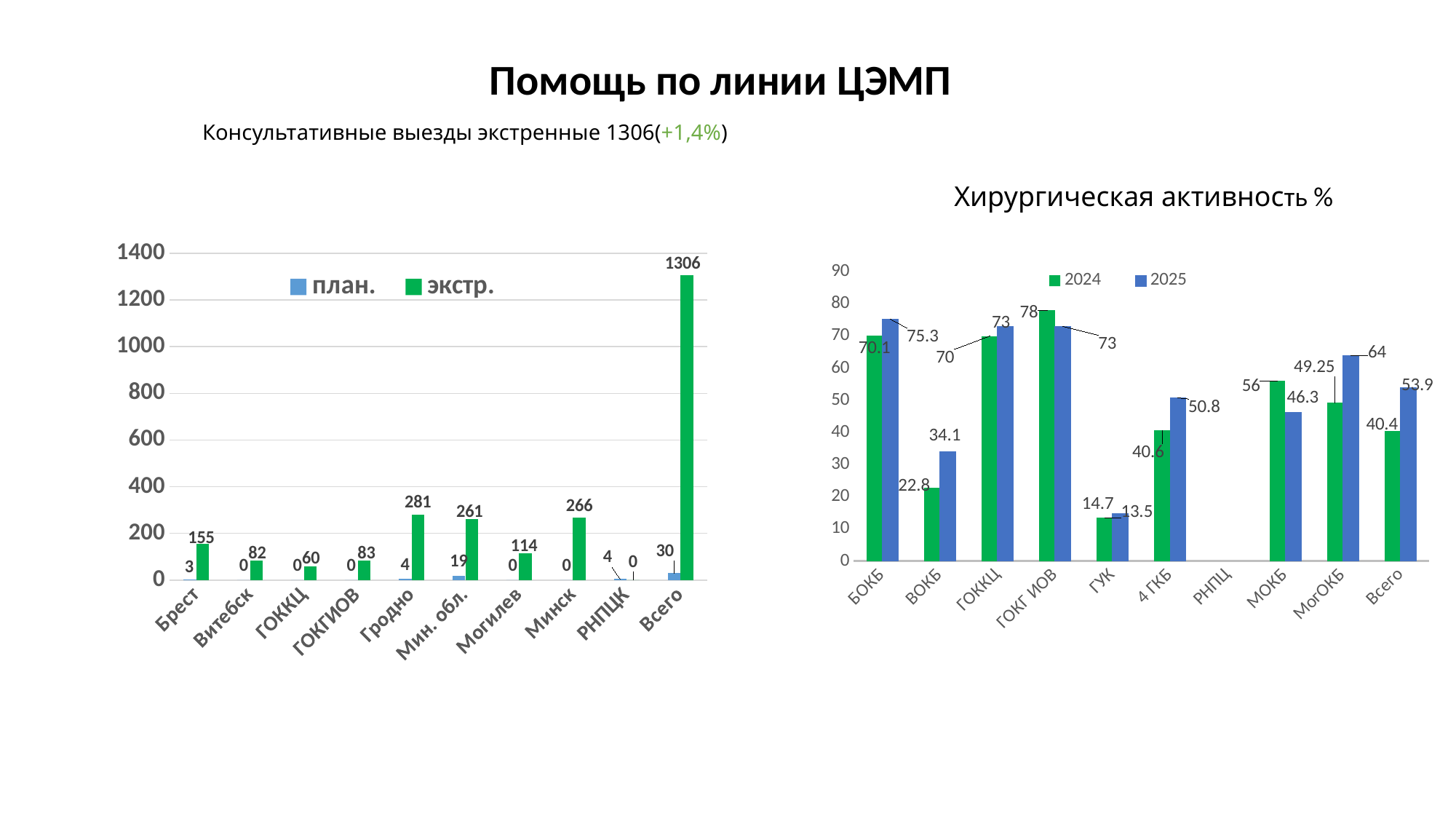
In the left chart, what is the difference between the экстр. values for Минск and Мин. обл.? 5 What kind of chart is the chart titled 'Хирургическая активность %'? Bar chart In the left chart, excluding Всего, which category has the highest экстр. value? Гродно In the chart titled 'Хирургическая активность %', what is the 2024 value for ВОКБ? 22.8 In the chart titled 'Хирургическая активность %', what is the difference between the 2025 and 2024 values for 4 ГКБ? 10.2 In the left chart, what is the план. value for Мин. обл.? 19 In the left chart, which is larger: the экстр. value for Могилев or for Витебск? Могилев In the chart titled 'Хирургическая активность %', which category has the lowest 2025 value? ГУК In the left chart, how many series does the legend list? 2 In the chart titled 'Хирургическая активность %', which is larger for МОКБ: the 2024 value or the 2025 value? 2024 In the left chart, what is the экстр. value for Гродно? 281 In the chart titled 'Хирургическая активность %', what is the 2025 value for МогОКБ? 64